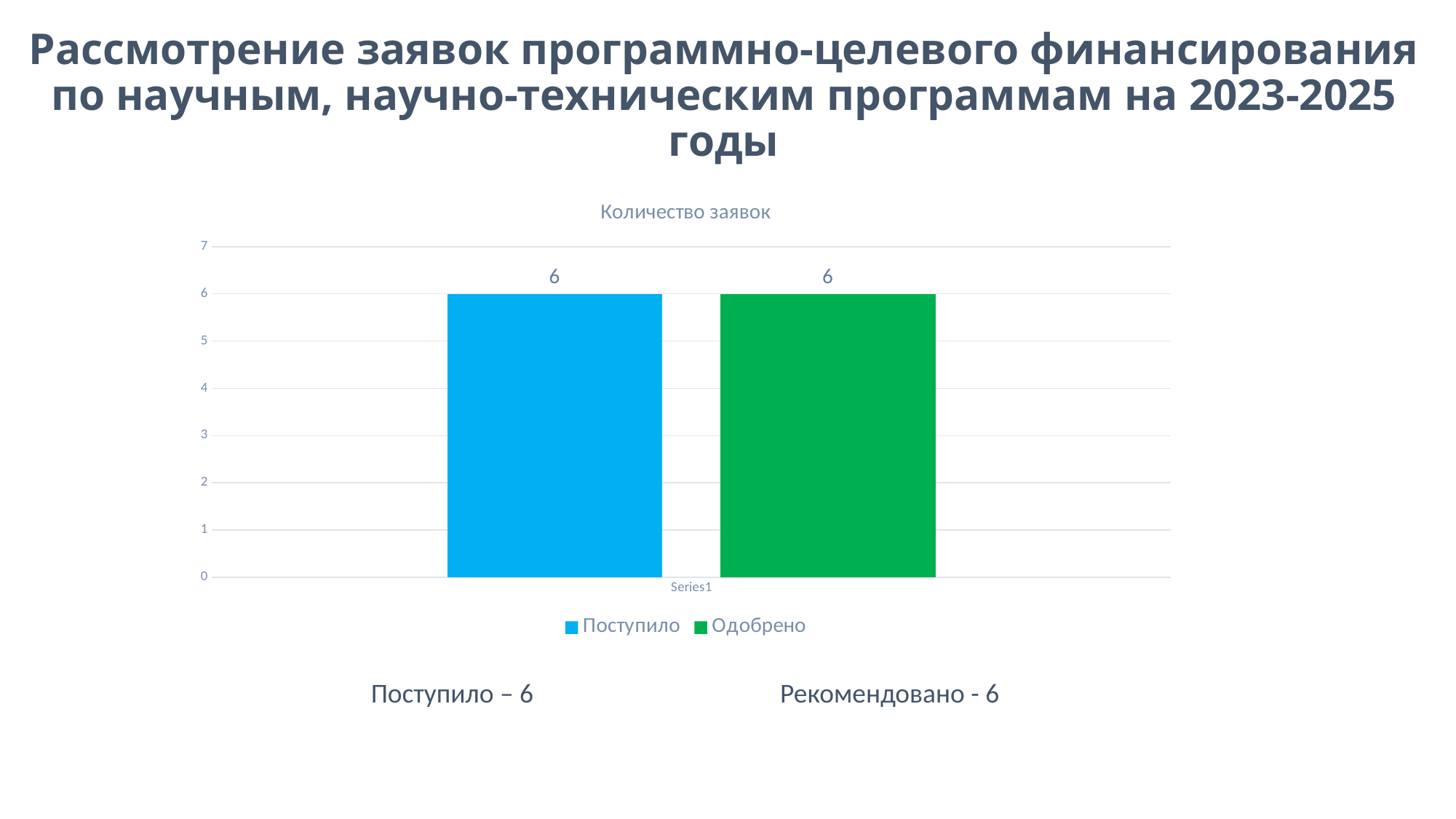
Is the value for Поступило greater or less than 5? greater What is the difference between the Поступило and Одобрено values? 0 What is the value of the Одобрено bar? 6 What is the value of the Поступило bar? 6 Is the value for Одобрено greater or less than 7? less What is the highest value shown on the vertical axis? 7 How many bars are plotted in the chart? 2 Which legend entry is shown in green? Одобрено What kind of chart is shown on the slide? Bar chart How many series does the legend list? 2 What is the title of the chart? Количество заявок